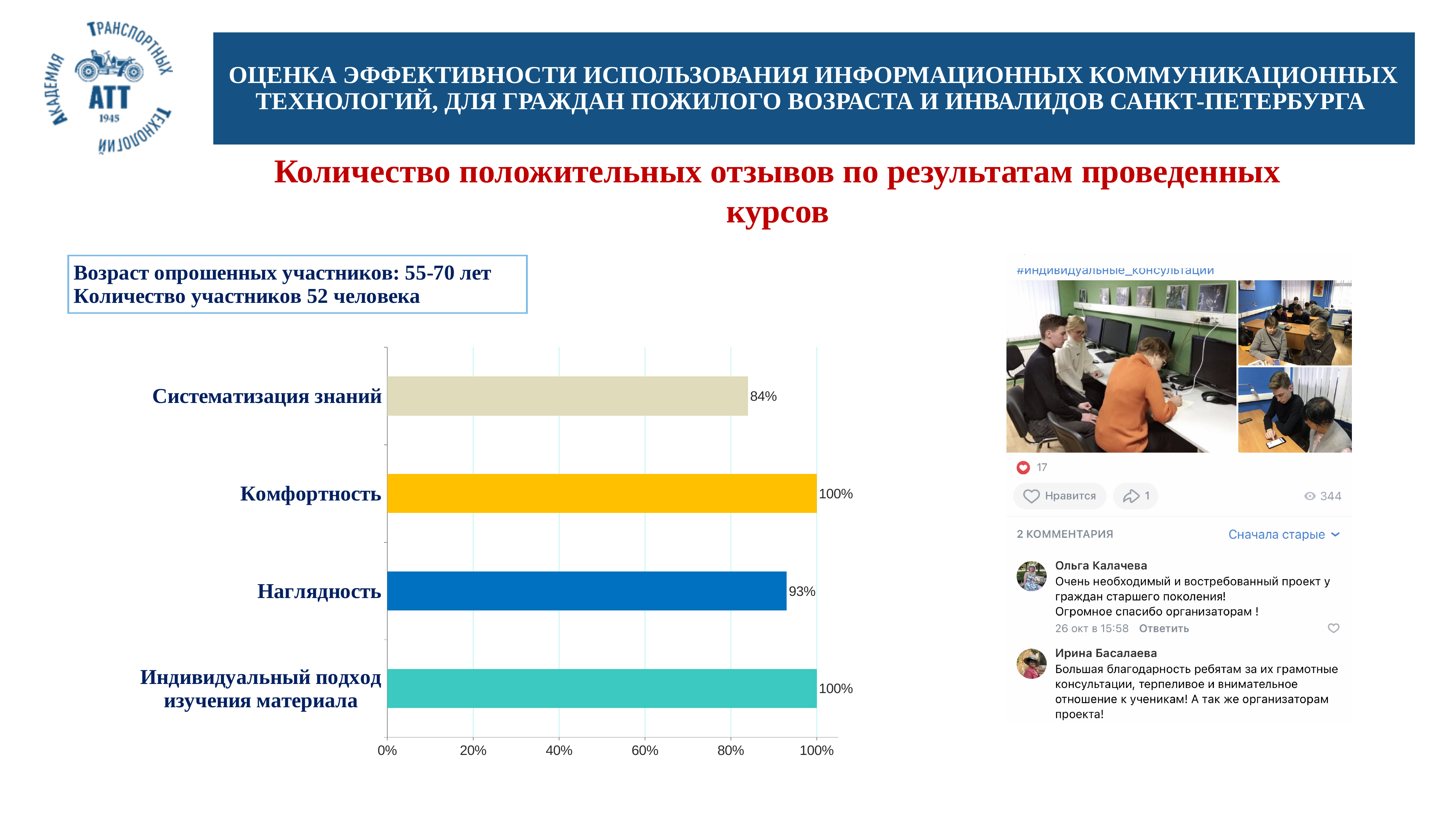
What is the difference between the values for Наглядность and Систематизация знаний? 9% What is the value for Наглядность? 93% What is the value for Индивидуальный подход изучения материала? 100% What is the difference between the values for Комфортность and Наглядность? 7% What is the value for Систематизация знаний? 84% What kind of chart is shown on the slide? bar chart How many categories are shown in the chart? 4 What colour is the bar for Комфортность? yellow Which is larger, the value for Наглядность or the value for Систематизация знаний? Наглядность Is the value for Систематизация знаний greater or less than 80%? greater What is the value for Комфортность? 100% Which category has the lowest value? Систематизация знаний